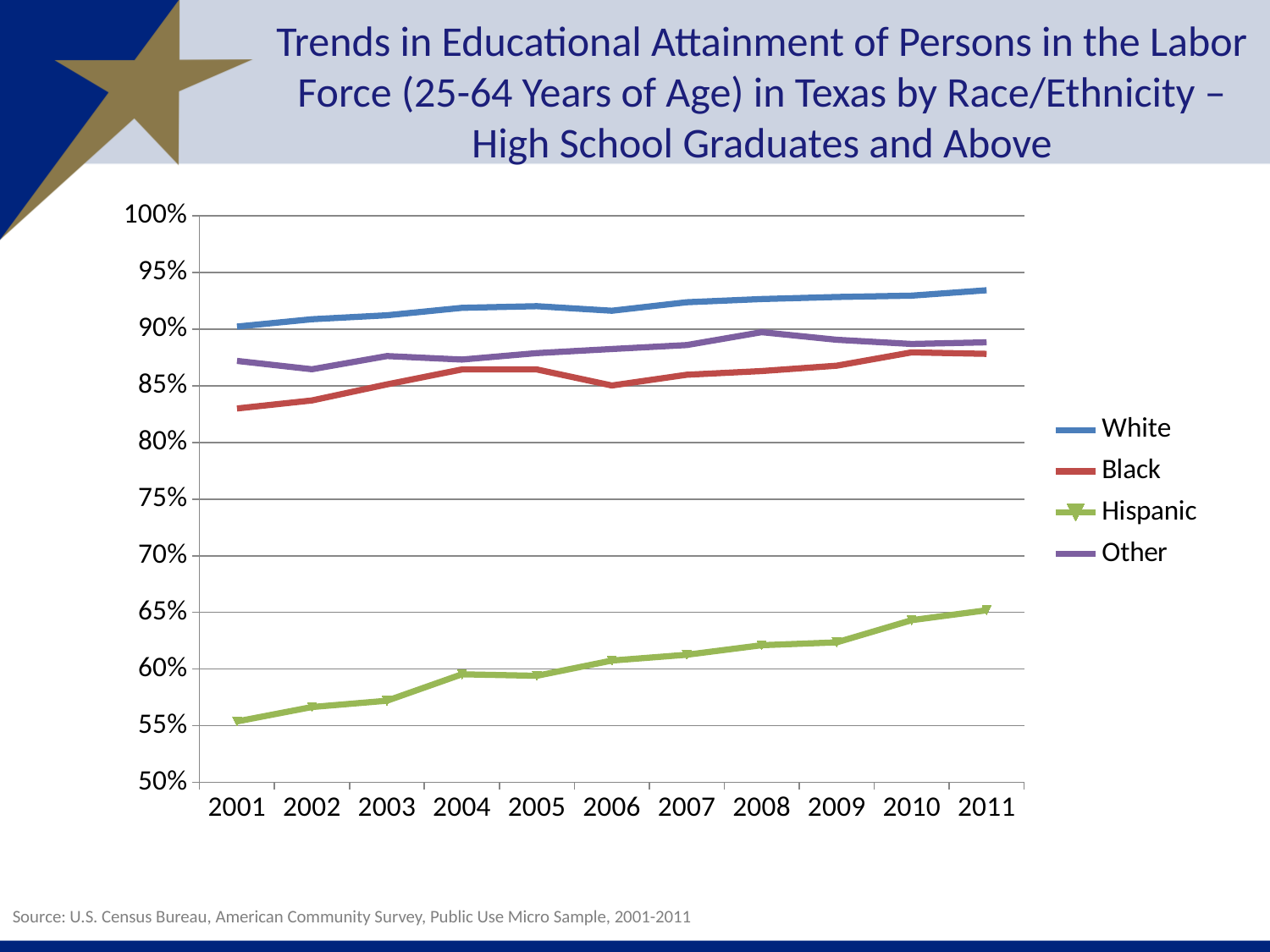
How many years are shown along the x axis? 11 Does the Hispanic line rise or fall from 2001 to 2011? rises What are the four entries listed in the legend? White, Black, Hispanic, Other Is the value for Black in 2001 greater or less than 85%? less Which series has the highest value in 2011? White What kind of chart is shown on the slide? line chart Is the value for Hispanic in 2001 greater or less than 60%? less In 2008, which is higher: the value for Other or the value for Black? Other How many series does the legend list? 4 Is the value for Hispanic in 2011 greater or less than 60%? greater Which series has the lowest value in 2011? Hispanic